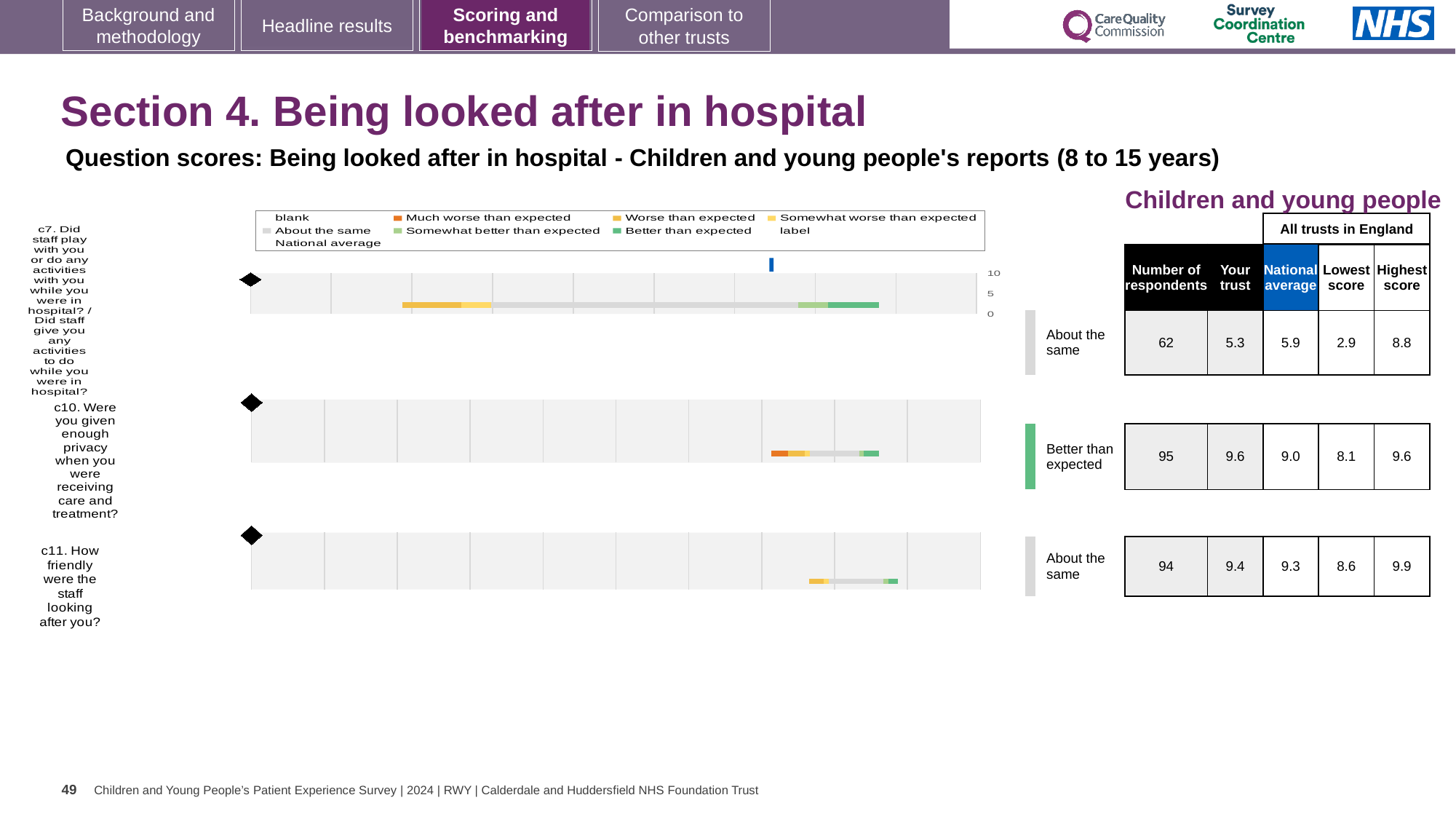
What kind of chart is used to show the question scores on this slide? bar chart For c11, which is larger: the 'Your trust' score or the national average? Your trust What benchmark category is shown for c10? Better than expected Which question has the lowest 'Your trust' score? c7 How many questions (rows) are plotted in the chart? 3 What is the lowest score across all trusts in England for c10? 8.1 What is the highest score across all trusts in England for c7? 8.8 What is the 'Your trust' score for c10 (Were you given enough privacy when you were receiving care and treatment?)? 9.6 Which question has the highest 'Your trust' score? c10 What is the national average score for c11 (How friendly were the staff looking after you?)? 9.3 How many respondents answered c7 (Did staff play with you or do any activities with you while you were in hospital?)? 62 For c10, what is the difference between the 'Your trust' score and the national average? 0.6